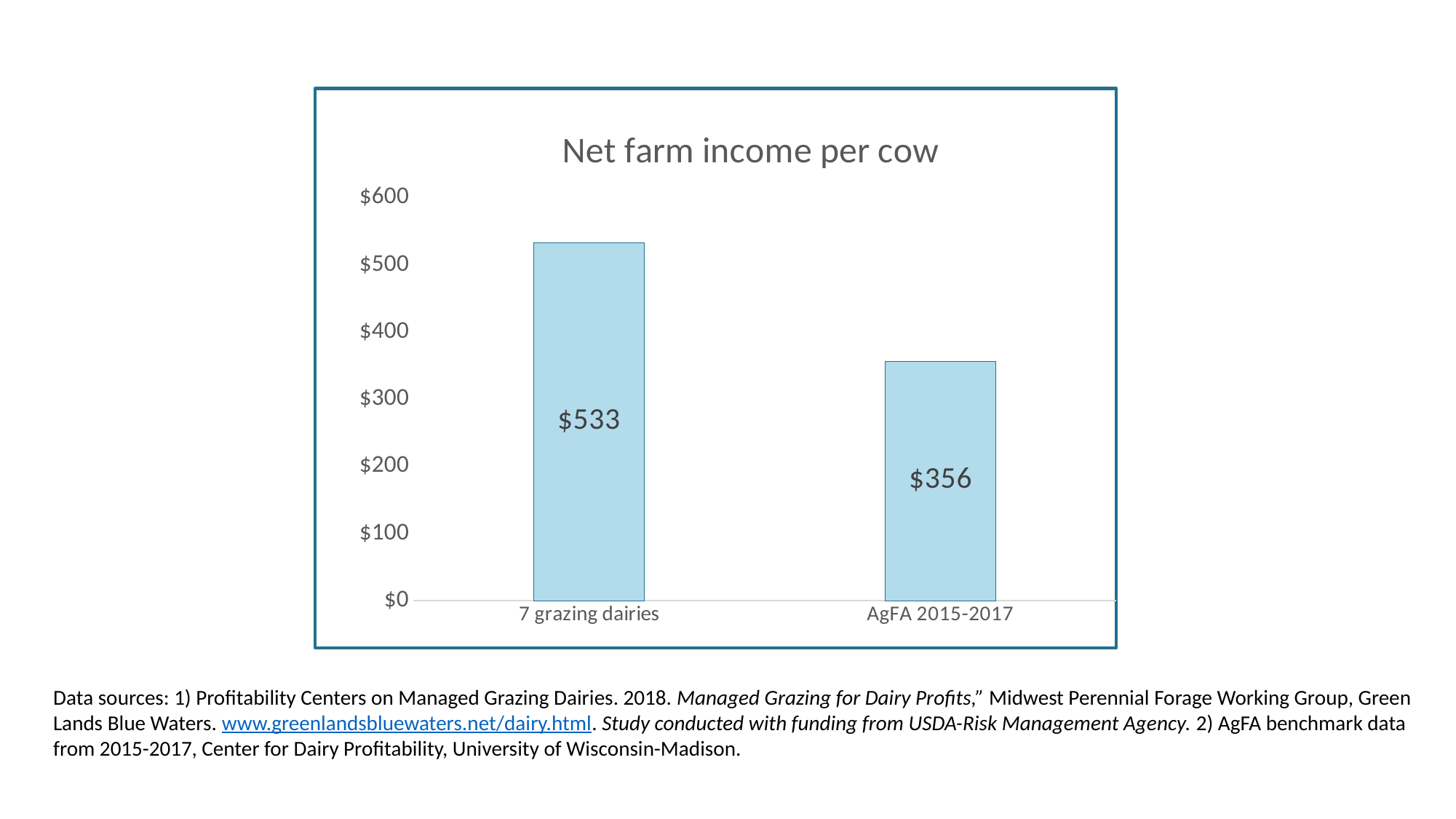
How many categories are shown on the chart? 2 Is the value for AgFA 2015-2017 greater or less than $400? less Is the value for 7 grazing dairies greater or less than $500? greater Which category has the highest net farm income per cow? 7 grazing dairies What is the net farm income per cow for the 7 grazing dairies? $533 Which is larger, the net farm income per cow for the 7 grazing dairies or for AgFA 2015-2017? 7 grazing dairies What kind of chart is shown on the slide? bar chart What is the title of the chart? Net farm income per cow What is the difference in net farm income per cow between the 7 grazing dairies and AgFA 2015-2017? $177 What is the highest value shown on the y axis? $600 What is the net farm income per cow for AgFA 2015-2017? $356 Which category has the lowest net farm income per cow? AgFA 2015-2017